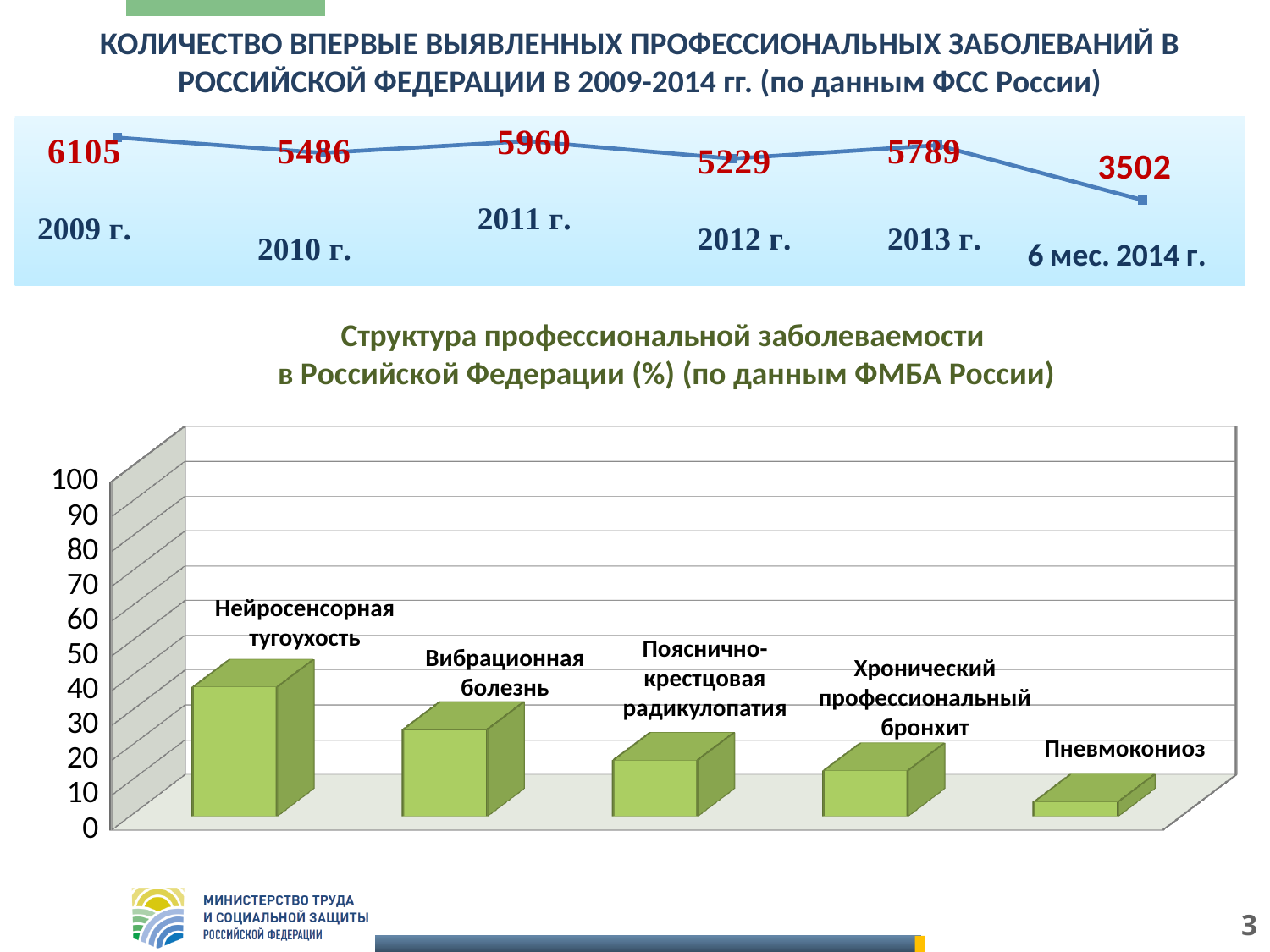
On the bottom bar chart, which category has the lowest value? Пневмокониоз On the bottom bar chart, is the value for Вибрационная болезнь greater or less than 50? less On the top line chart, which year has the highest value? 2009 г. On the top line chart, what is the difference between the values for 2011 г. and 2012 г.? 731 On the top line chart, what is the value for 6 мес. 2014 г.? 3502 How many data points are plotted on the top line chart? 6 On the bottom bar chart, which category has the highest value? Нейросенсорная тугоухость What kind of chart is the bottom chart titled 'Структура профессиональной заболеваемости в Российской Федерации (%)'? bar chart On the top line chart, which point has the lowest value? 6 мес. 2014 г. What kind of chart is the top chart on the slide? line chart On the top line chart, what is the value for 2009 г.? 6105 On the top line chart, which is larger: the value for 2010 г. or the value for 2013 г.? 2013 г.